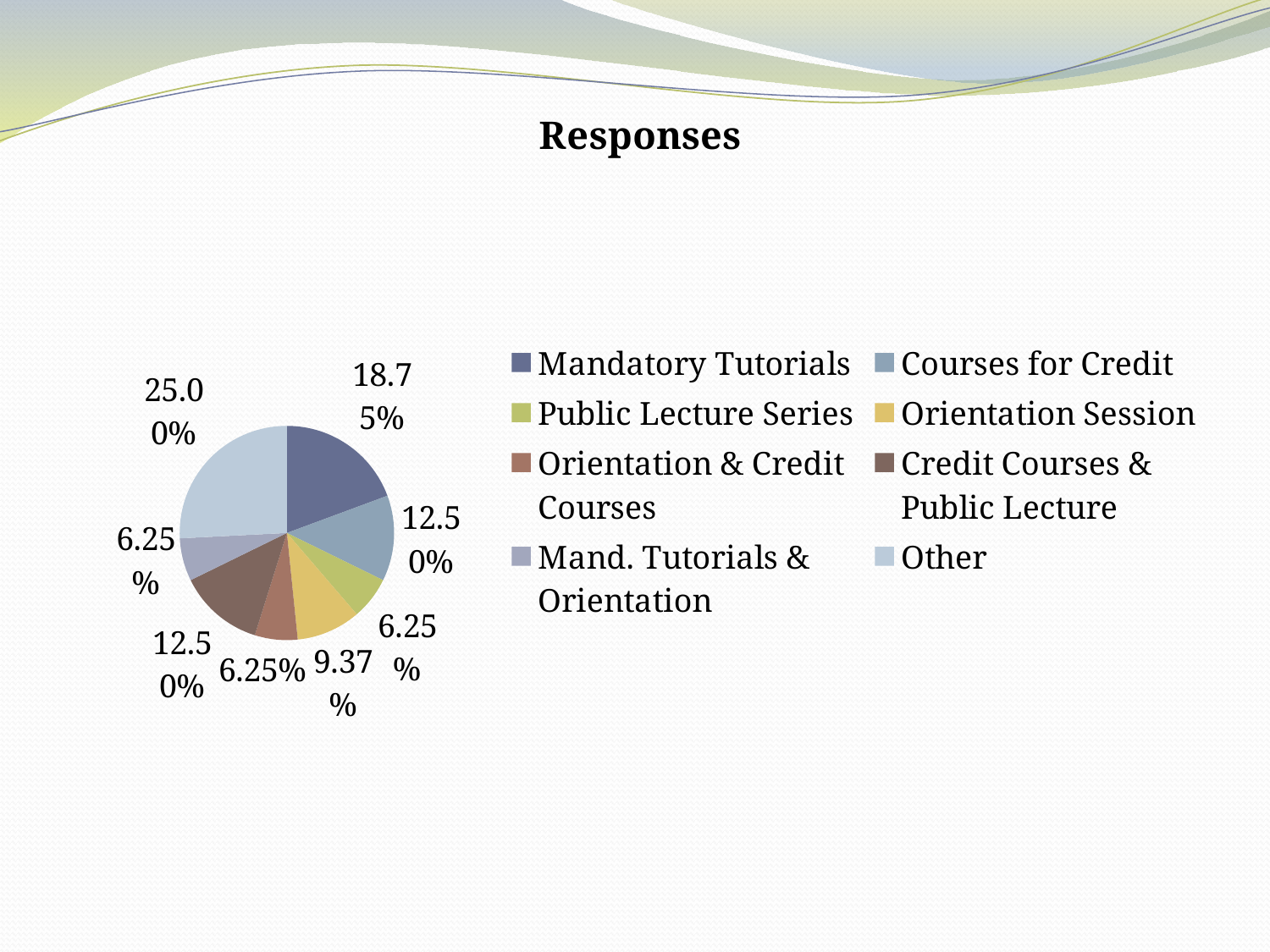
Which legend entry is shown in the lightest blue colour? Other What is the title of the chart? Responses Which category has the largest share of the pie? Other What percentage of responses is labelled for Other? 25.00% What type of chart is shown on the slide? pie chart How many categories are listed in the legend? 8 Which is larger, the share for Mandatory Tutorials or the share for Courses for Credit? Mandatory Tutorials How many slices does the pie chart have? 8 What percentage of responses is labelled for Mandatory Tutorials? 18.75% What percentage of responses is labelled for Courses for Credit? 12.50% What is the difference in percentage points between the Other slice and the Mandatory Tutorials slice? 6.25 What percentage of responses is labelled for Orientation Session? 9.37%